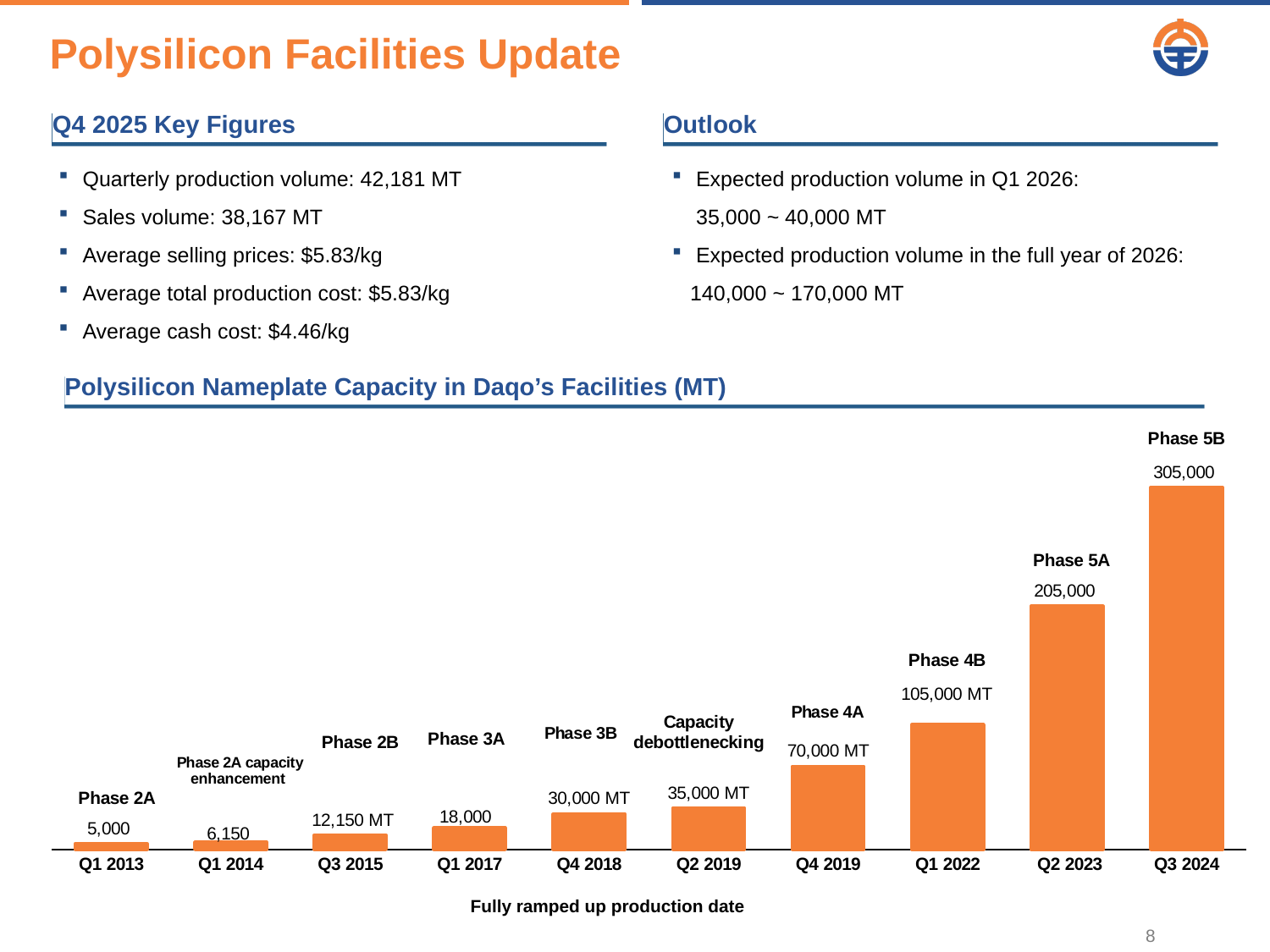
What is the difference in nameplate capacity between Q4 2019 and Q2 2019? 35,000 MT What is the nameplate capacity shown for Q3 2024 (Phase 5B)? 305,000 What is the difference in nameplate capacity between Q3 2024 and Q2 2023? 100,000 How many fully ramped up production dates are shown on the x axis of the chart? 10 What is the nameplate capacity shown for Q2 2019 (Capacity debottlenecking)? 35,000 MT What kind of chart is used to show Polysilicon Nameplate Capacity in Daqo's Facilities? Bar chart Which has a larger nameplate capacity, Q1 2017 or Q4 2018? Q4 2018 What is the nameplate capacity shown for Q1 2013 (Phase 2A)? 5,000 Do the nameplate capacity values rise or fall from Q1 2013 to Q3 2024? Rise Which fully ramped up production date has the highest nameplate capacity? Q3 2024 What is the nameplate capacity shown for Q1 2022 (Phase 4B)? 105,000 MT Which fully ramped up production date has the lowest nameplate capacity? Q1 2013